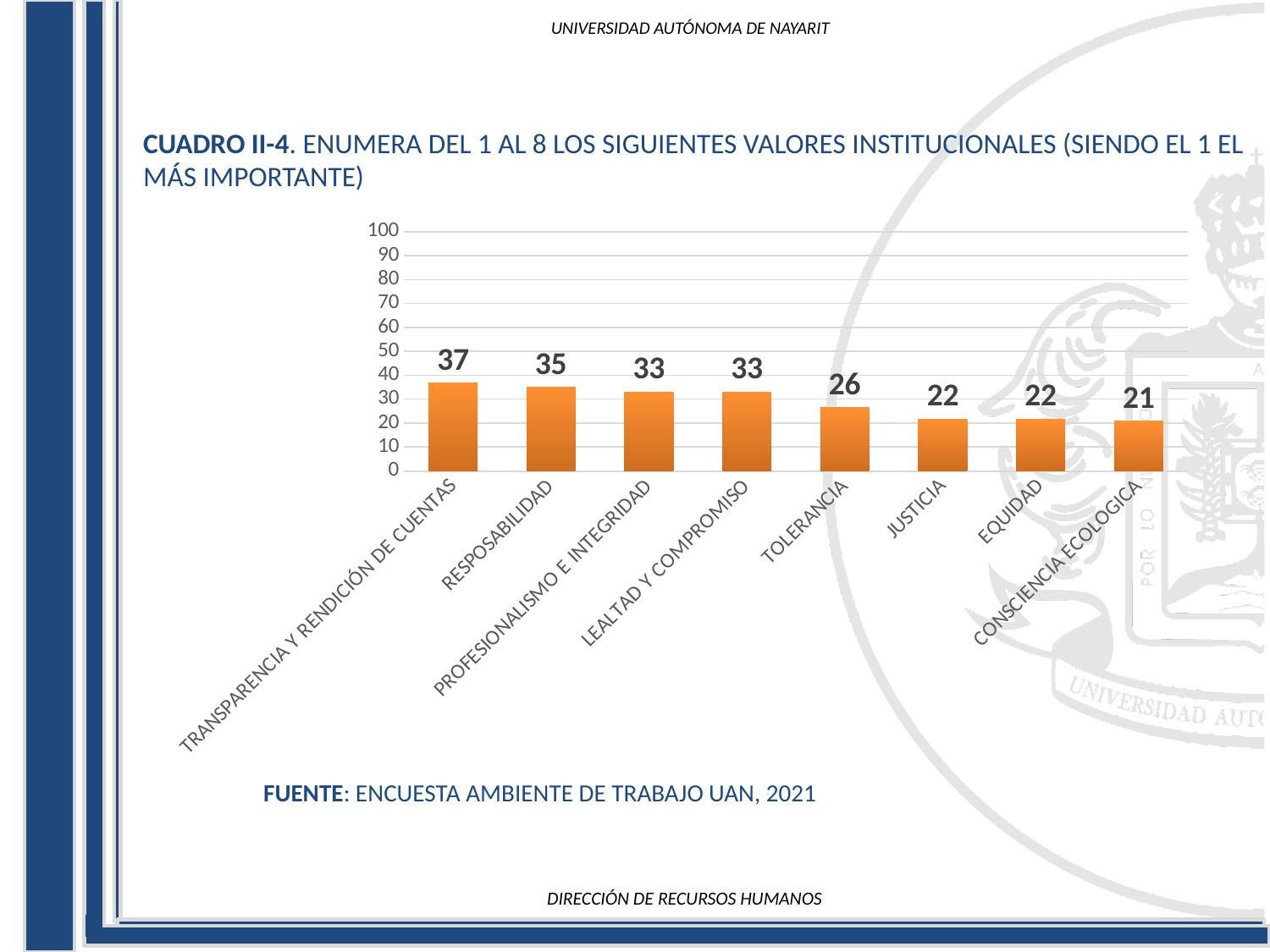
Which category has the highest value? TRANSPARENCIA Y RENDICIÓN DE CUENTAS Is the value for TRANSPARENCIA Y RENDICIÓN DE CUENTAS greater or less than 30? greater How many categories are shown in the chart? 8 What is the difference between the values for RESPOSABILIDAD and JUSTICIA? 13 Do the values rise or fall from left to right along the x axis? Fall What is the value for CONSCIENCIA ECOLOGICA? 21 What is the source cited below the chart? ENCUESTA AMBIENTE DE TRABAJO UAN, 2021 Which is larger, the value for LEALTAD Y COMPROMISO or the value for EQUIDAD? LEALTAD Y COMPROMISO What is the value for TRANSPARENCIA Y RENDICIÓN DE CUENTAS? 37 What kind of chart is shown on the slide? Bar chart Which category has the lowest value? CONSCIENCIA ECOLOGICA What is the value for TOLERANCIA? 26